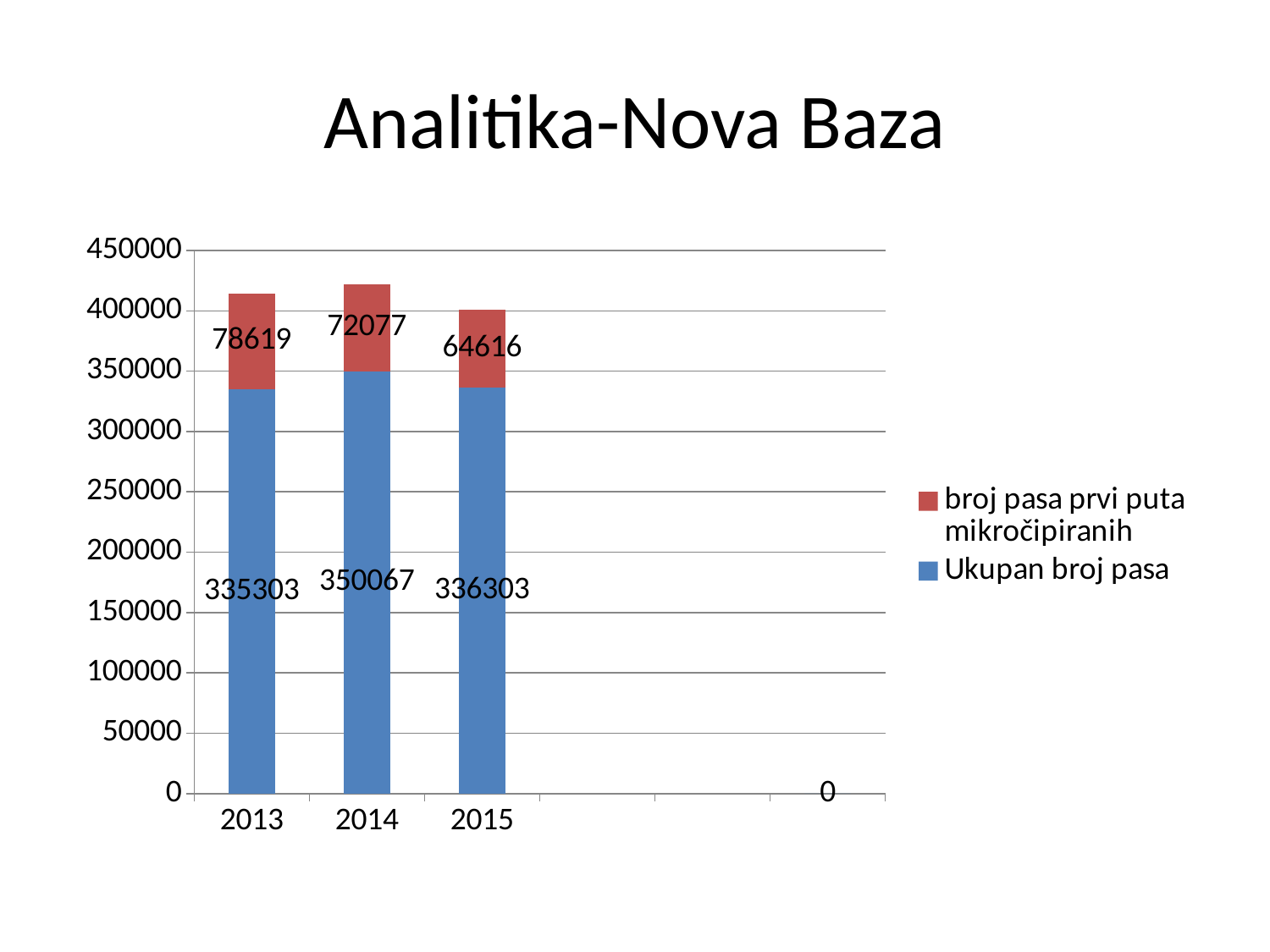
What is the difference between 'Ukupan broj pasa' in 2014 and in 2013? 14764 What is the title of the chart? Analitika-Nova Baza Which year has the lowest value for 'Ukupan broj pasa'? 2013 What type of chart is shown on the slide? stacked bar chart What is the value of 'Ukupan broj pasa' for 2014? 350067 How many years are labelled on the x axis? 3 How many series does the legend list? 2 What is the value of 'broj pasa prvi puta mikročipiranih' for 2015? 64616 Which year has the highest value for 'broj pasa prvi puta mikročipiranih'? 2013 What is the total of the stacked bar for 2014? 422144 Does 'broj pasa prvi puta mikročipiranih' rise or fall from 2013 to 2015? fall Is 'broj pasa prvi puta mikročipiranih' larger in 2013 or in 2014? 2013